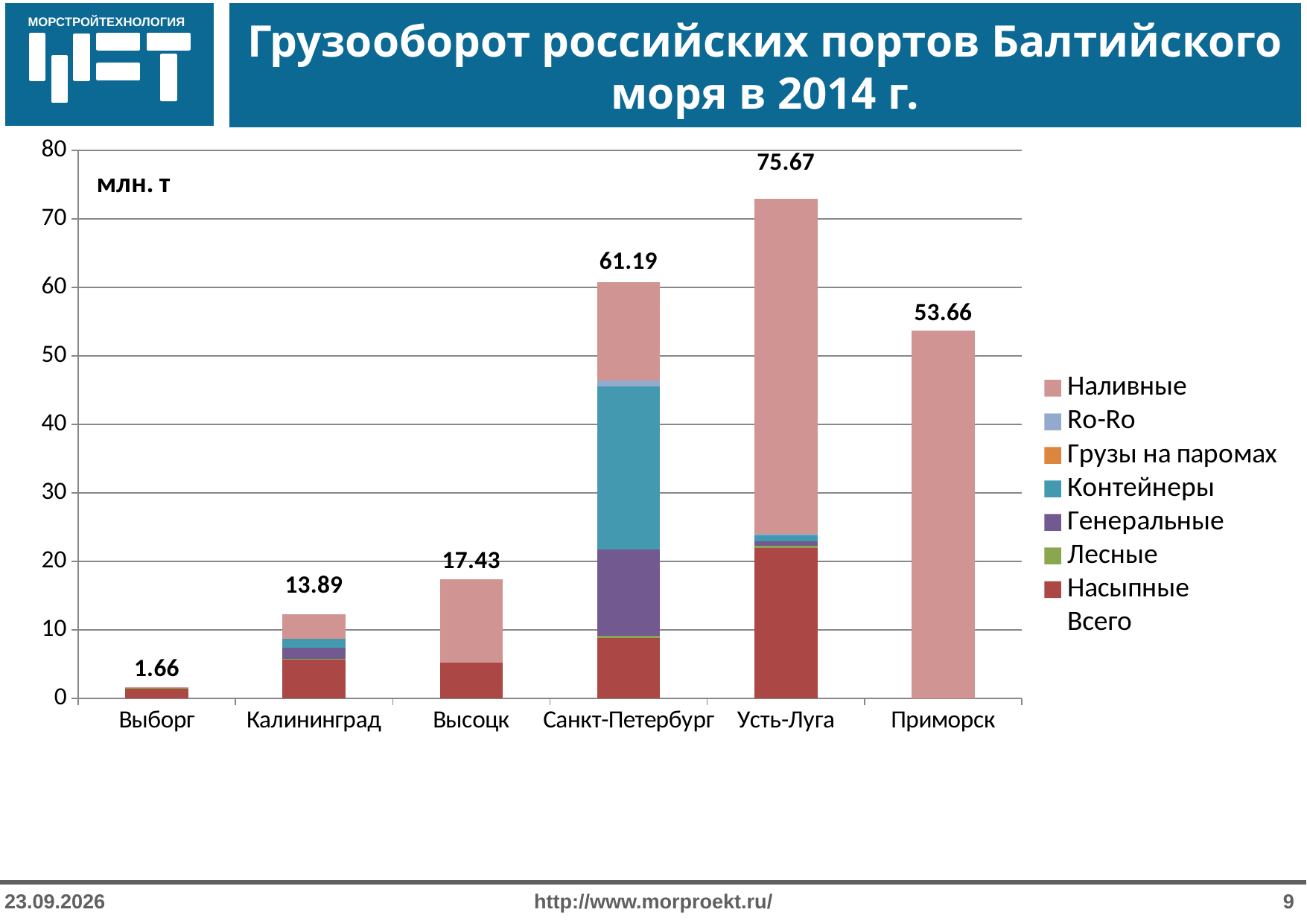
What is the difference between the totals for Высоцк and Калининград? 3.54 Which has a larger total, Санкт-Петербург or Приморск? Санкт-Петербург What is the total value labelled for Калининград? 13.89 What is the total value labelled for Приморск? 53.66 How many ports are shown on the x axis? 6 What is the total cargo turnover (Всего) shown for Усть-Луга? 75.67 Is the Насыпные value for Усть-Луга greater or less than 20? greater Which port has the highest total cargo turnover? Усть-Луга What kind of chart is shown on the slide? Stacked bar chart What is the difference between the totals for Усть-Луга and Санкт-Петербург? 14.48 How many entries does the legend list? 8 Which port has the lowest total cargo turnover? Выборг